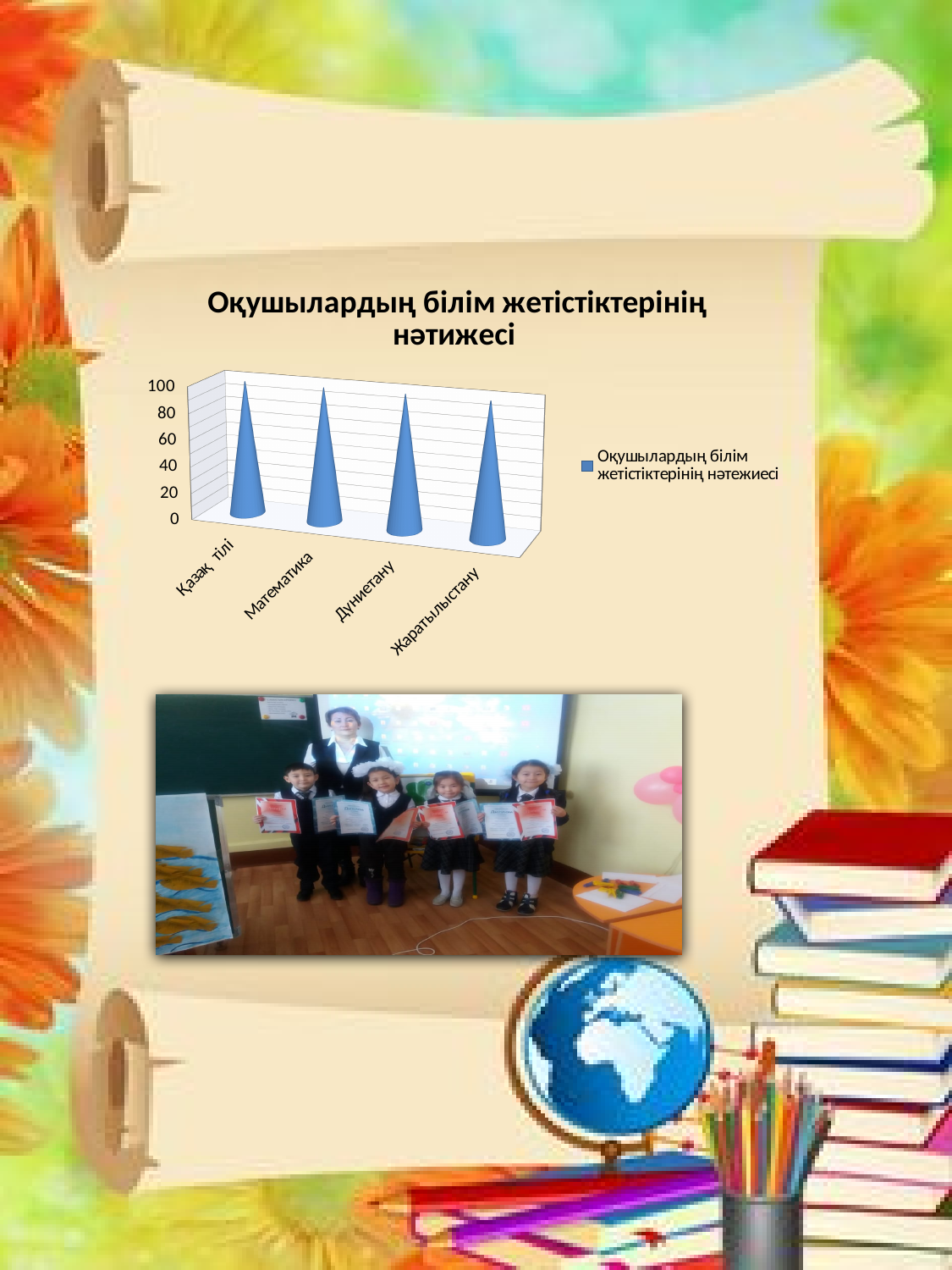
How many series does the chart legend list? 1 What kind of chart is shown on the slide? bar chart What is the title of the chart? Оқушылардың білім жетістіктерінің нәтижесі How many categories are shown on the x axis of the chart? 4 Is the value for Дүниетану greater or less than 40? greater What is the highest value shown on the vertical axis of the chart? 100 Is the value for Жаратылыстану greater or less than 60? greater What is the first category on the x axis of the chart? Қазақ тілі Is the value for Қазақ тілі greater or less than 60? greater